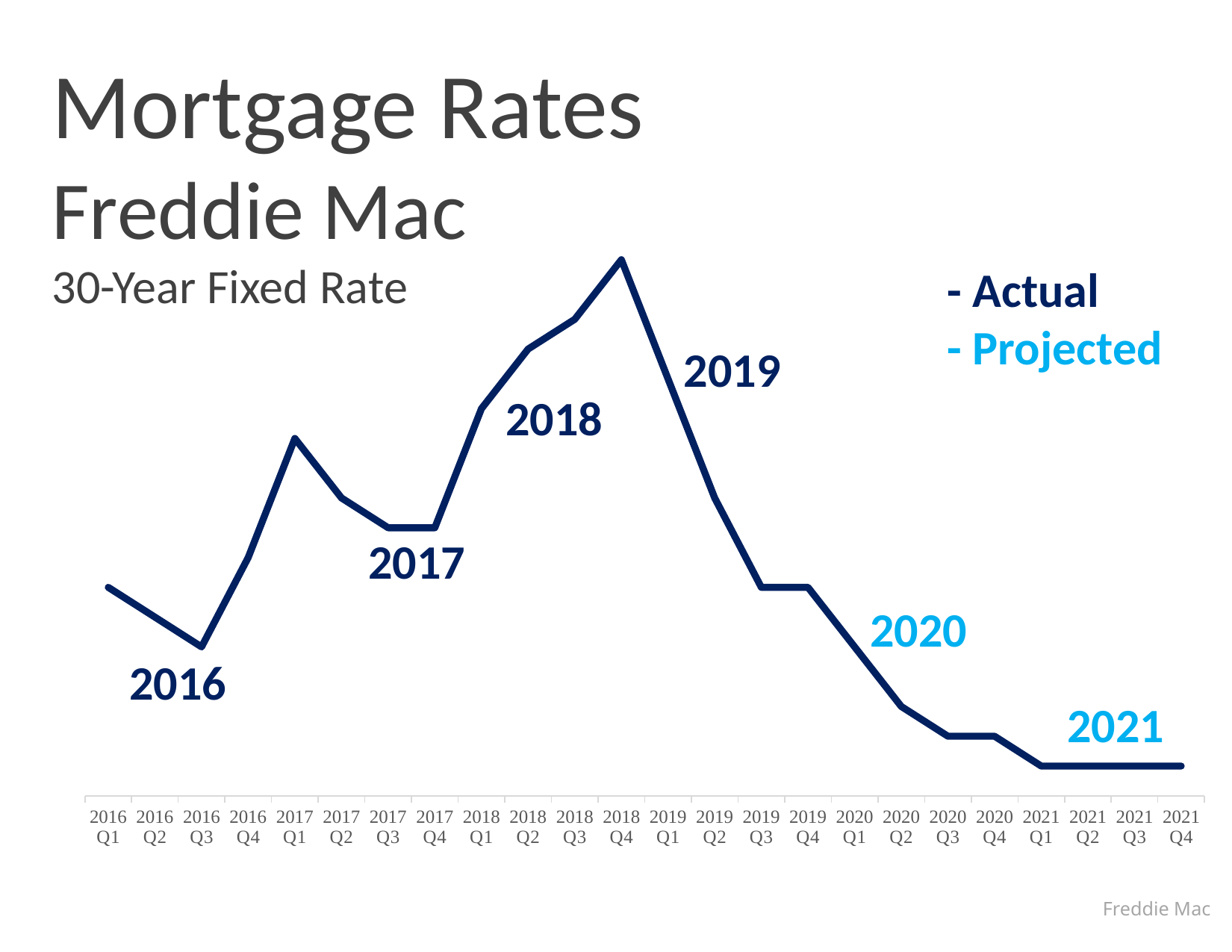
How many entries does the legend list? 2 Does the line rise or fall from 2019 Q1 to 2020 Q4? fall How many quarterly points are plotted along the x axis? 24 Which is higher on the chart, the value for 2019 Q1 or the value for 2020 Q4? 2019 Q1 In which quarter does the 30-year fixed rate line reach its highest point? 2018 Q4 What is the source cited at the bottom of the slide? Freddie Mac Which is higher on the chart, the value for 2018 Q4 or the value for 2016 Q3? 2018 Q4 Which is higher on the chart, the value for 2017 Q1 or the value for 2016 Q1? 2017 Q1 In which year does the line reach its lowest level? 2021 What kind of chart is shown on the slide? line chart Does the line rise or fall from 2017 Q4 to 2018 Q4? rise What are the two legend entries on the chart? Actual and Projected